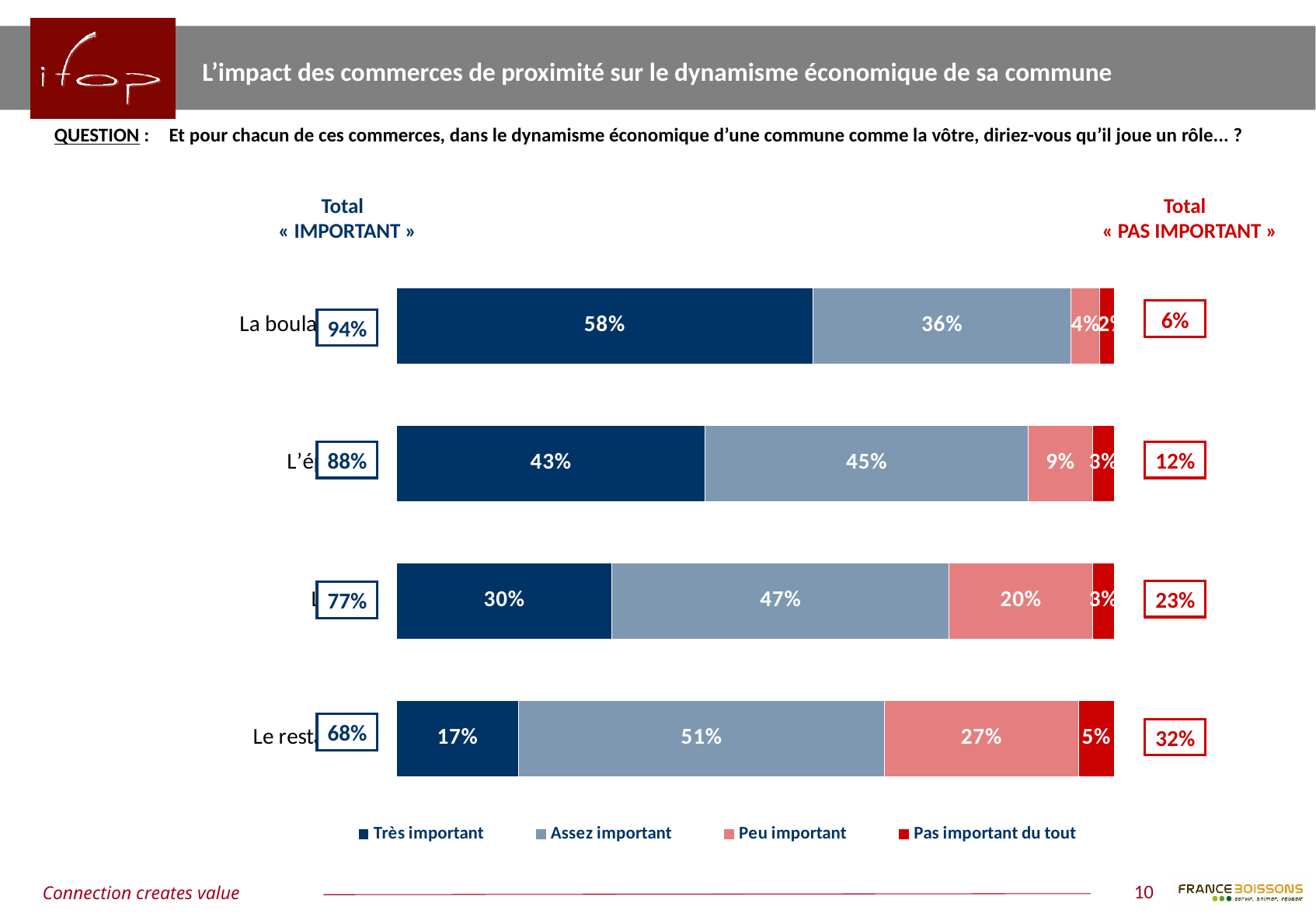
What is the 'Très important' value for the top bar of the chart? 58% What is the Total « IMPORTANT » value shown for the second bar from the top? 88% Which legend entry is shown in dark blue? Très important Which is larger: the 'Assez important' value of the second bar or of the third bar? The third bar (47%) Which bar has the highest 'Très important' value? The top bar (58%) How many series does the chart legend list? 4 What is the difference between the 'Très important' value of the top bar and that of the bottom bar? 41 percentage points What is the 'Peu important' value for the third bar from the top? 20% What is the 'Assez important' value for the bottom bar of the chart? 51% What kind of chart is shown on the slide? Stacked bar chart How many bars (categories) are plotted in the chart? 4 Which bar has the lowest 'Très important' value? The bottom bar (17%)